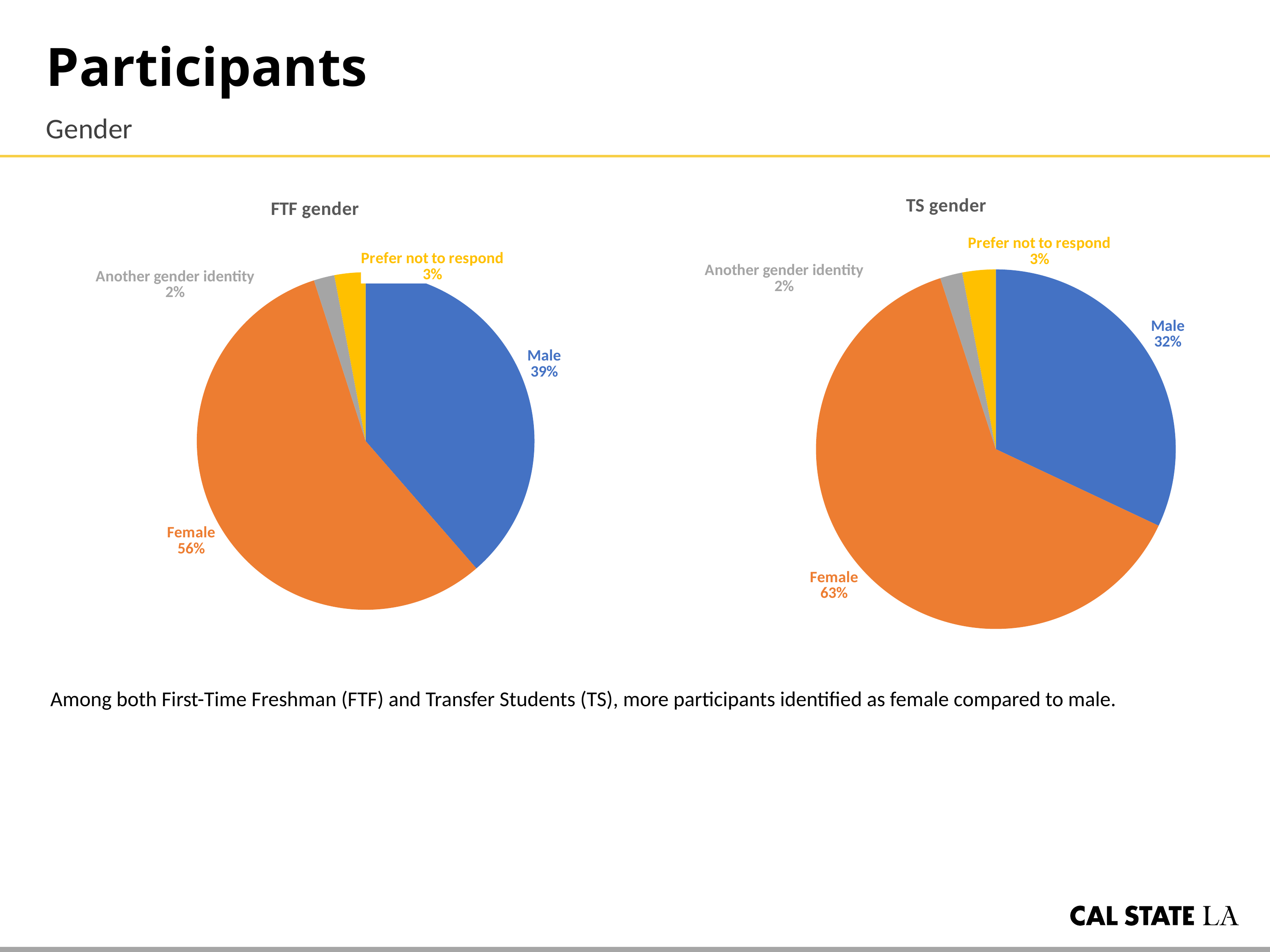
In the TS gender chart, what colour is the Female slice? Orange What type of chart is the FTF gender chart? Pie chart In the FTF gender chart, which category has the largest slice? Female In the TS gender chart, what is the difference between the Female and Male percentages? 31% In the FTF gender chart, what share of the pie is Prefer not to respond? 3% In the TS gender chart, what percentage of participants identified as Male? 32% In the FTF gender chart, what percentage of participants identified as Female? 56% How many categories are shown in the TS gender chart? 4 Which is larger: the Male share in the FTF gender chart or the Male share in the TS gender chart? FTF gender In the TS gender chart, which category has the smallest slice? Another gender identity In the TS gender chart, what share of the pie is Another gender identity? 2% In the FTF gender chart, what is the difference between the Female and Male percentages? 17%